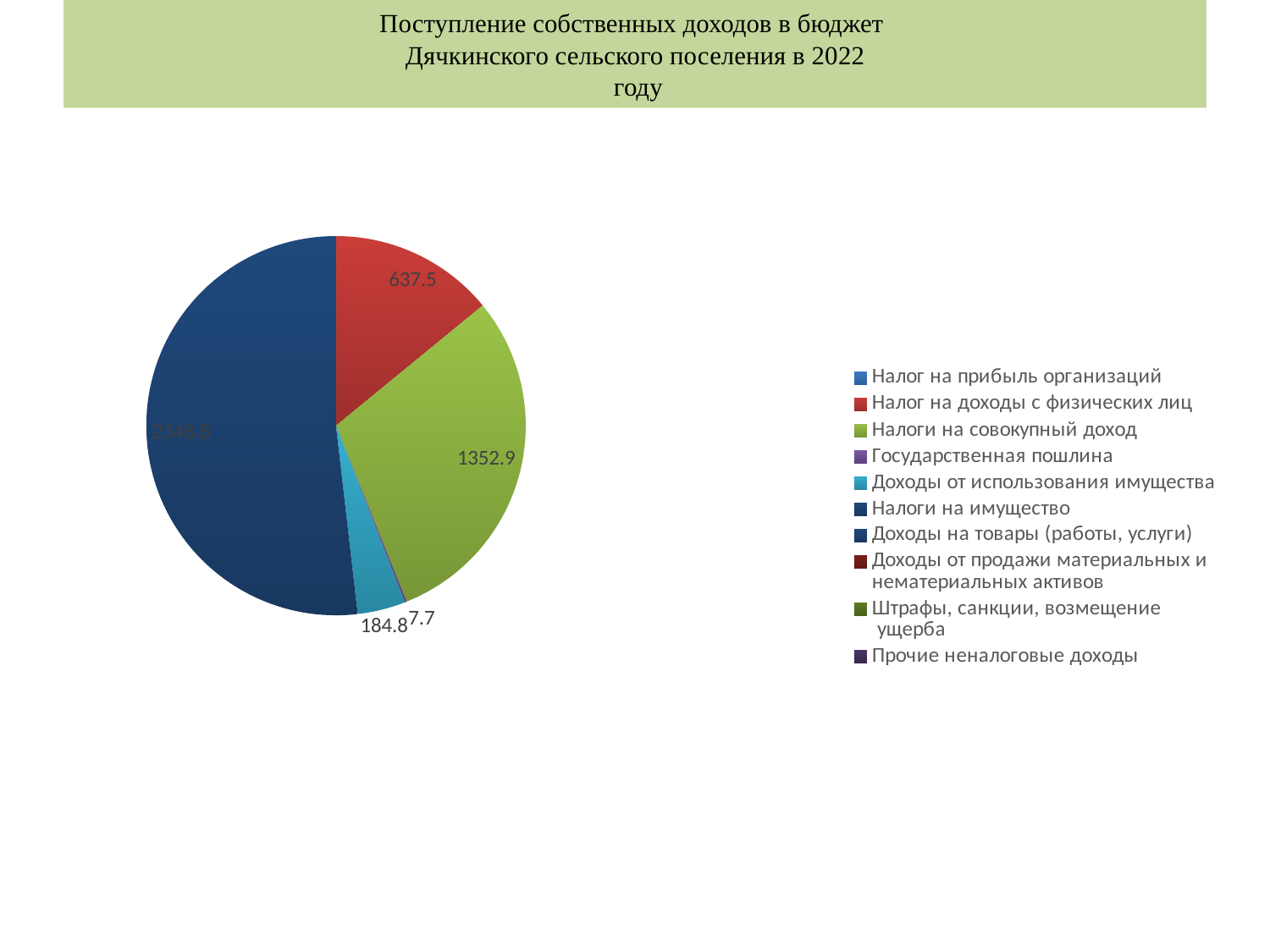
What is the value for Налоги на имущество? 2348.8 Which category has the largest slice of the pie? Налоги на имущество Which is larger, Налог на доходы с физических лиц or Налоги на совокупный доход? Налоги на совокупный доход What is the value for Налог на доходы с физических лиц? 637.5 What is the title of the chart? Поступление собственных доходов в бюджет Дячкинского сельского поселения в 2022 году What is the value for Налоги на совокупный доход? 1352.9 How many entries does the legend list? 10 What is the difference between Доходы от использования имущества and Государственная пошлина? 177.1 What kind of chart is shown on the slide? pie chart What is the value for Государственная пошлина? 7.7 What is the difference between Налоги на совокупный доход and Налог на доходы с физических лиц? 715.4 What is the value for Доходы от использования имущества? 184.8